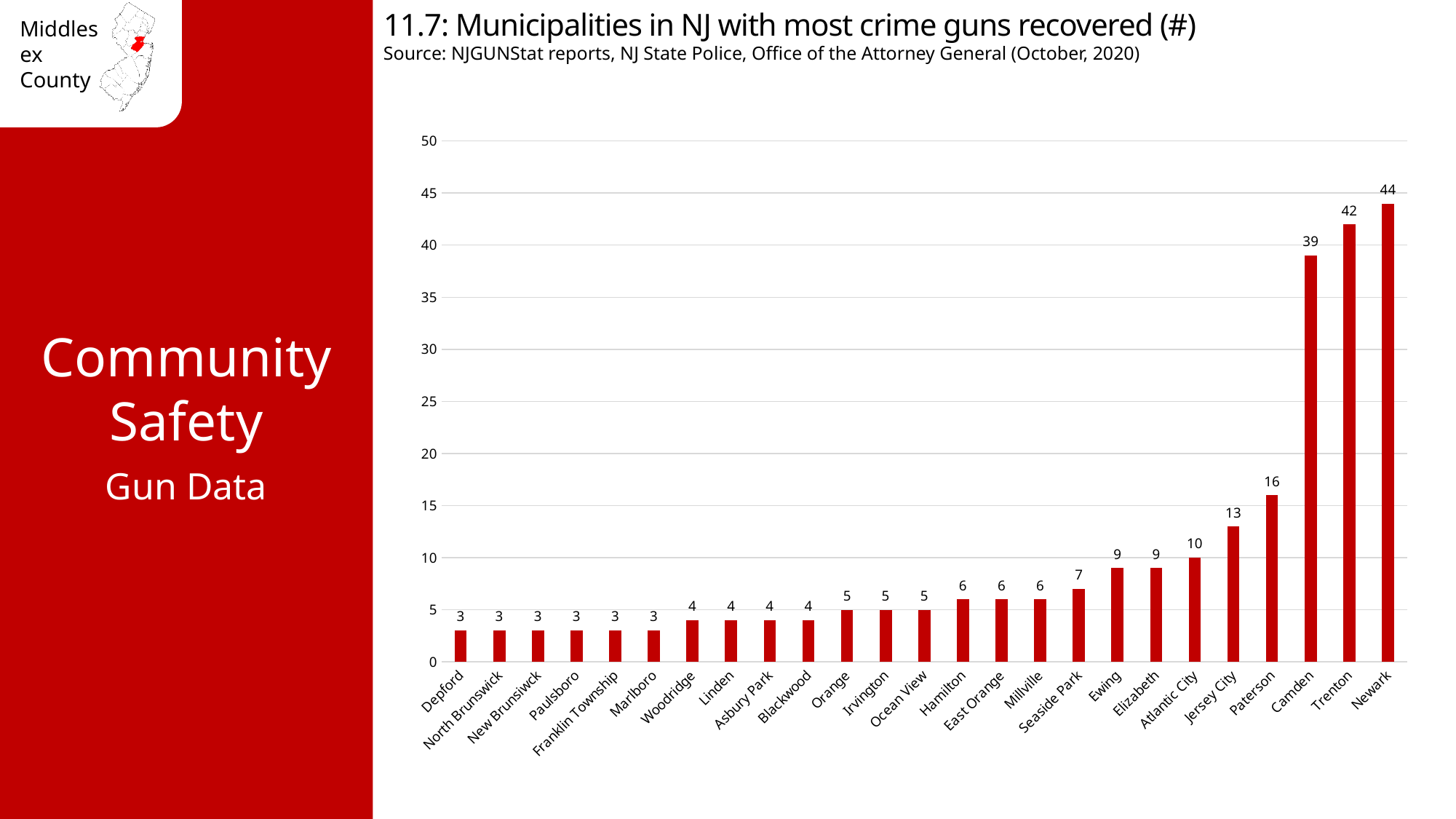
How many municipalities are shown on the chart? 25 Is the value for Trenton greater or less than 40? greater Which municipality has the highest number of crime guns recovered? Newark How many crime guns were recovered in Newark? 44 What is the difference between the values for Newark and Trenton? 2 What is the difference between the values for Camden and Paterson? 23 Do the values generally rise or fall from left to right along the x axis? Rise What kind of chart is shown on the slide? Bar chart What is the value shown for Camden? 39 What is the value shown for Paterson? 16 What is the value shown for Atlantic City? 10 Which has a larger value, Jersey City or Ewing? Jersey City